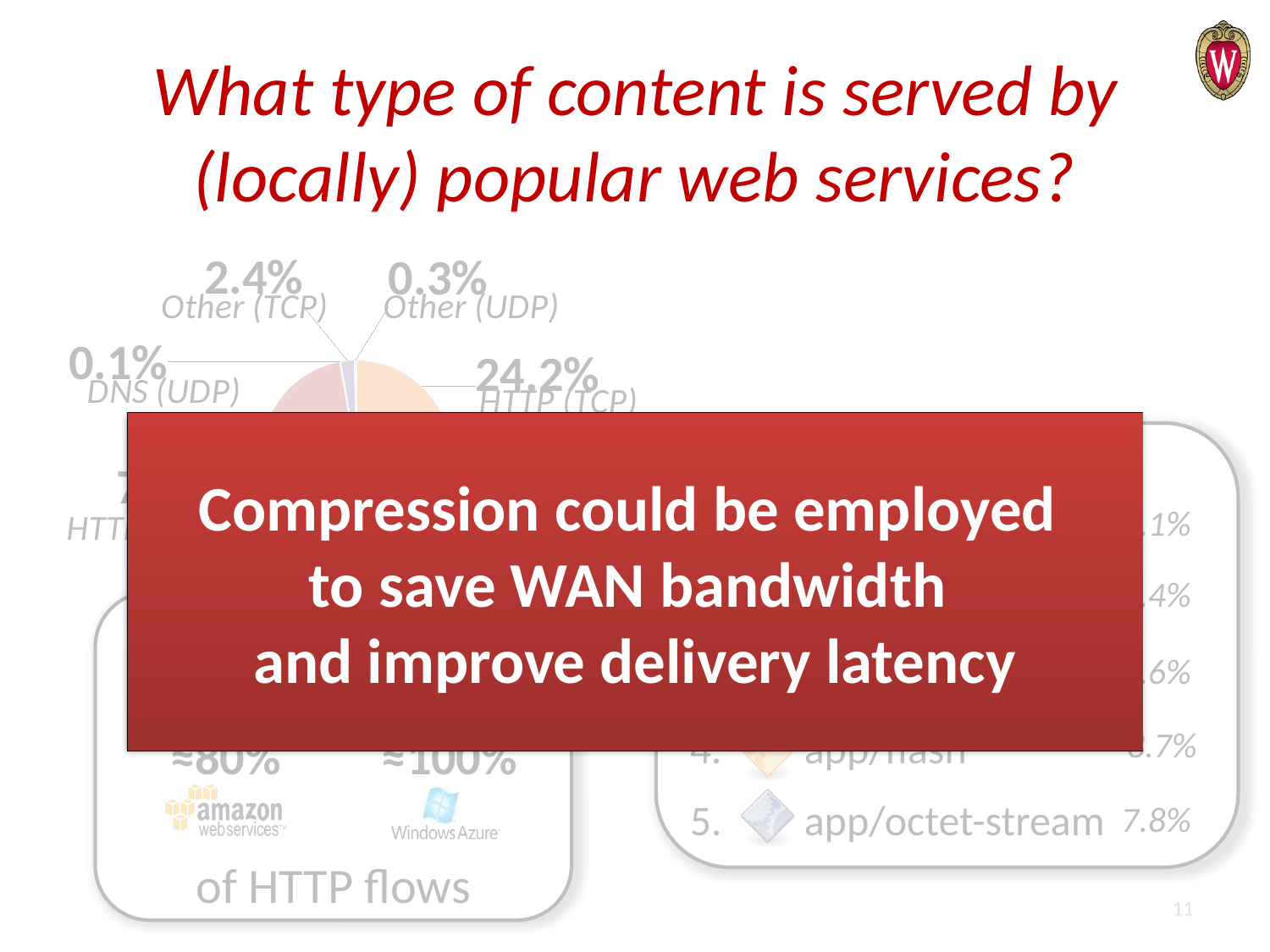
What share of the pie is labelled HTTP (TCP)? 24.2% Which is larger, the share for HTTP (TCP) or the share for Other (TCP)? HTTP (TCP) Which slice of the pie has the smallest share? DNS (UDP) What is the difference between the shares for Other (UDP) and DNS (UDP)? 0.2% Is the share for HTTP (TCP) greater or less than 20%? greater What share of the pie is labelled Other (UDP)? 0.3% Which is larger, the share for Other (TCP) or the share for Other (UDP)? Other (TCP) What share of the pie is labelled DNS (UDP)? 0.1% What share of the pie is labelled Other (TCP)? 2.4% What is the difference between the shares for HTTP (TCP) and Other (TCP)? 21.8% What kind of chart is shown on the slide? pie chart What is the title of the slide containing the pie chart? What type of content is served by (locally) popular web services?